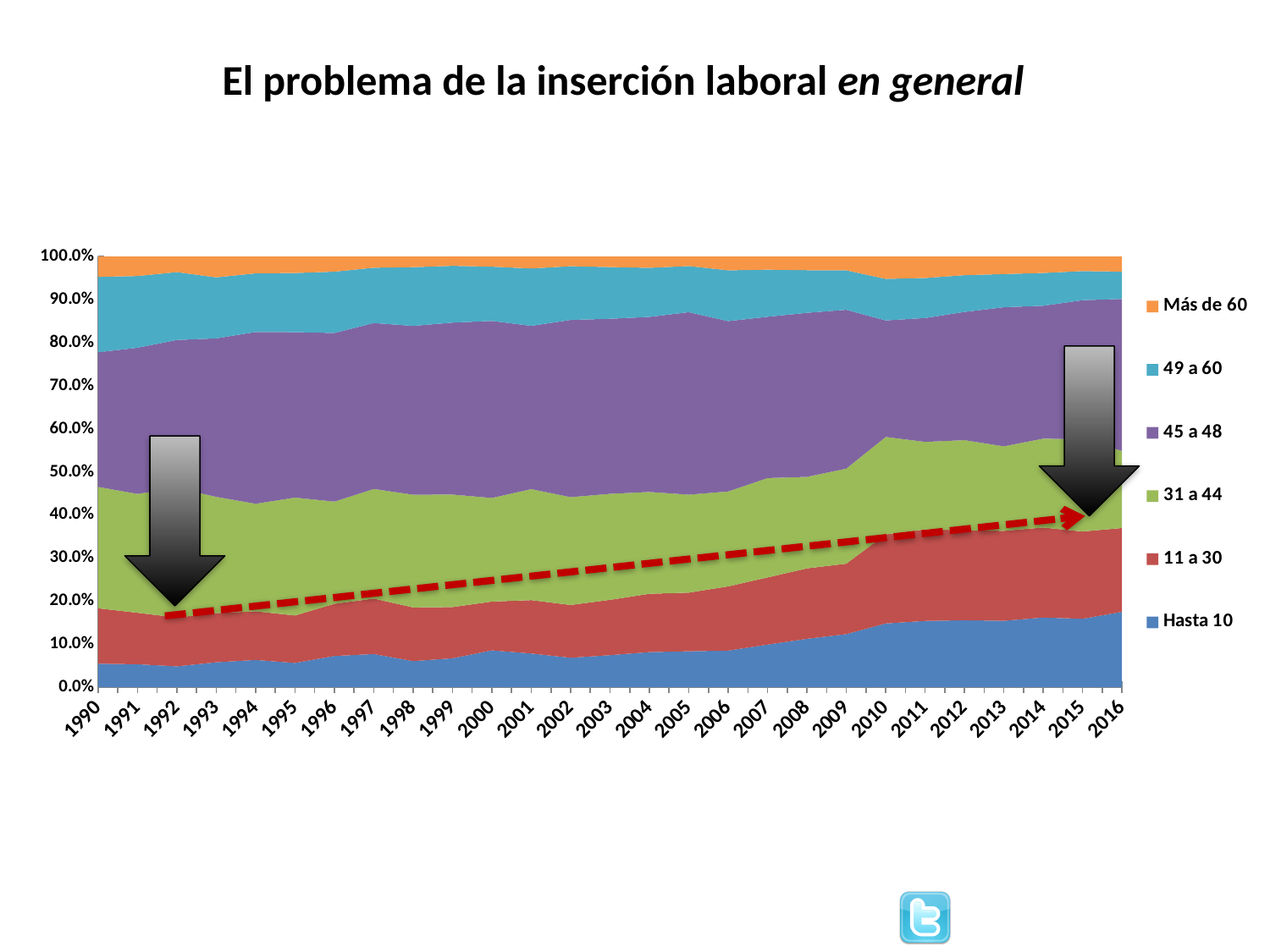
Does the 31 a 44 band get thicker or thinner from 1990 to 2016? thinner Is the value for Hasta 10 in 2016 greater or less than 10%? greater How many series does the legend list? 6 Is the value for Hasta 10 in 1990 greater or less than 10%? less What kind of chart is shown on the slide? Stacked area chart What is the first year shown on the x axis? 1990 Which series is plotted at the bottom of the stack? Hasta 10 Does the 49 a 60 band get thicker or thinner from 1990 to 2016? thinner What colour represents the series Más de 60 in the legend? Orange Does the Hasta 10 band rise or fall from 1990 to 2016? rises How many years are shown along the x axis? 27 Which is larger, the value for Hasta 10 in 1990 or in 2016? 2016